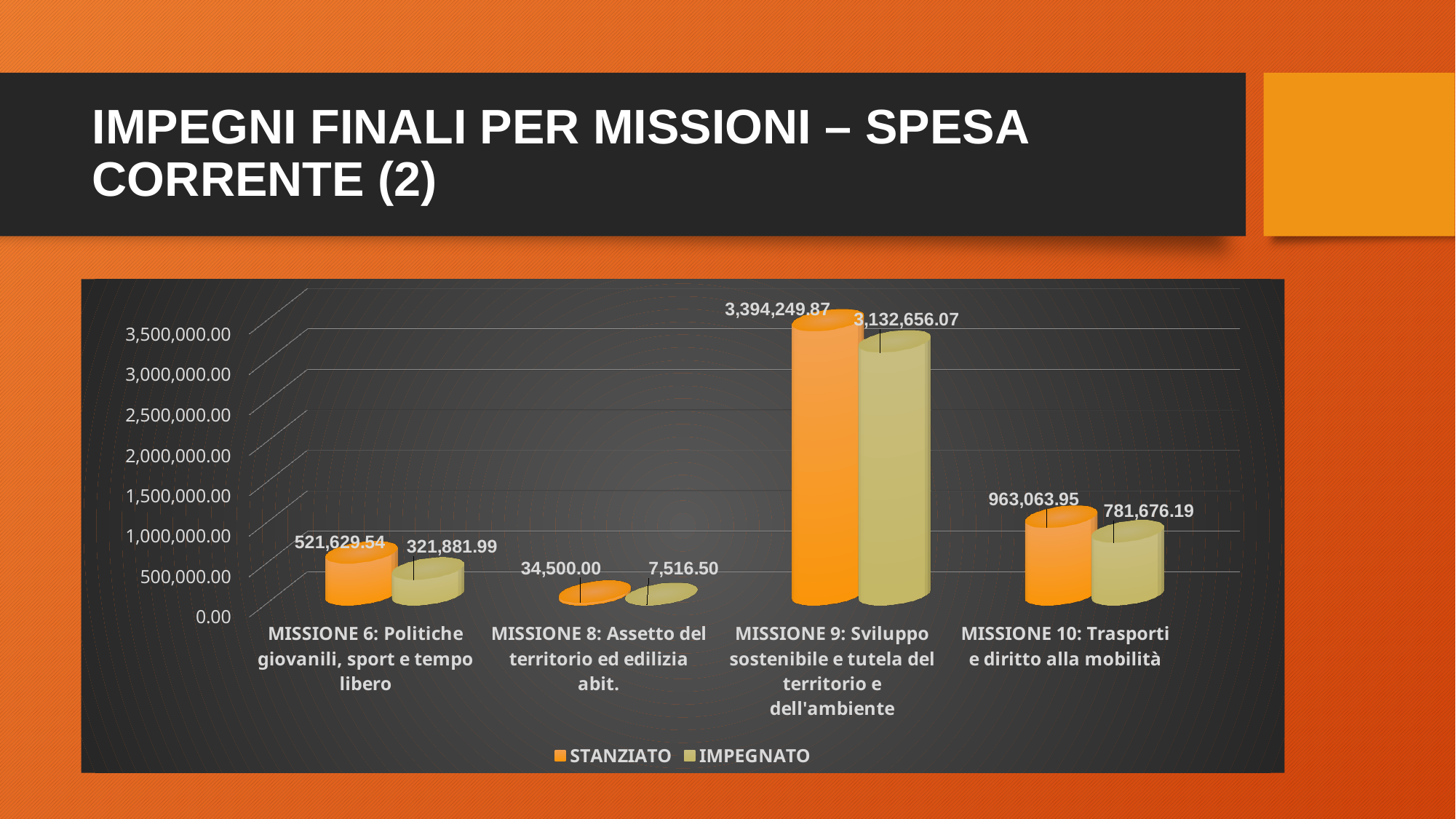
How many series does the legend list? 2 What is the STANZIATO value for MISSIONE 9: Sviluppo sostenibile e tutela del territorio e dell'ambiente? 3,394,249.87 What is the difference between the STANZIATO and IMPEGNATO values for MISSIONE 9? 261,593.80 What is the IMPEGNATO value for MISSIONE 10: Trasporti e diritto alla mobilità? 781,676.19 What kind of chart is shown on the slide? Bar chart What is the IMPEGNATO value for MISSIONE 8: Assetto del territorio ed edilizia abit.? 7,516.50 Which is larger: the IMPEGNATO value for MISSIONE 6 or the IMPEGNATO value for MISSIONE 10? MISSIONE 10 How many missions (categories) are shown on the x axis? 4 What is the difference between the STANZIATO and IMPEGNATO values for MISSIONE 8? 26,983.50 What is the STANZIATO value for MISSIONE 6: Politiche giovanili, sport e tempo libero? 521,629.54 Which mission has the highest STANZIATO value? MISSIONE 9: Sviluppo sostenibile e tutela del territorio e dell'ambiente Which mission has the lowest IMPEGNATO value? MISSIONE 8: Assetto del territorio ed edilizia abit.